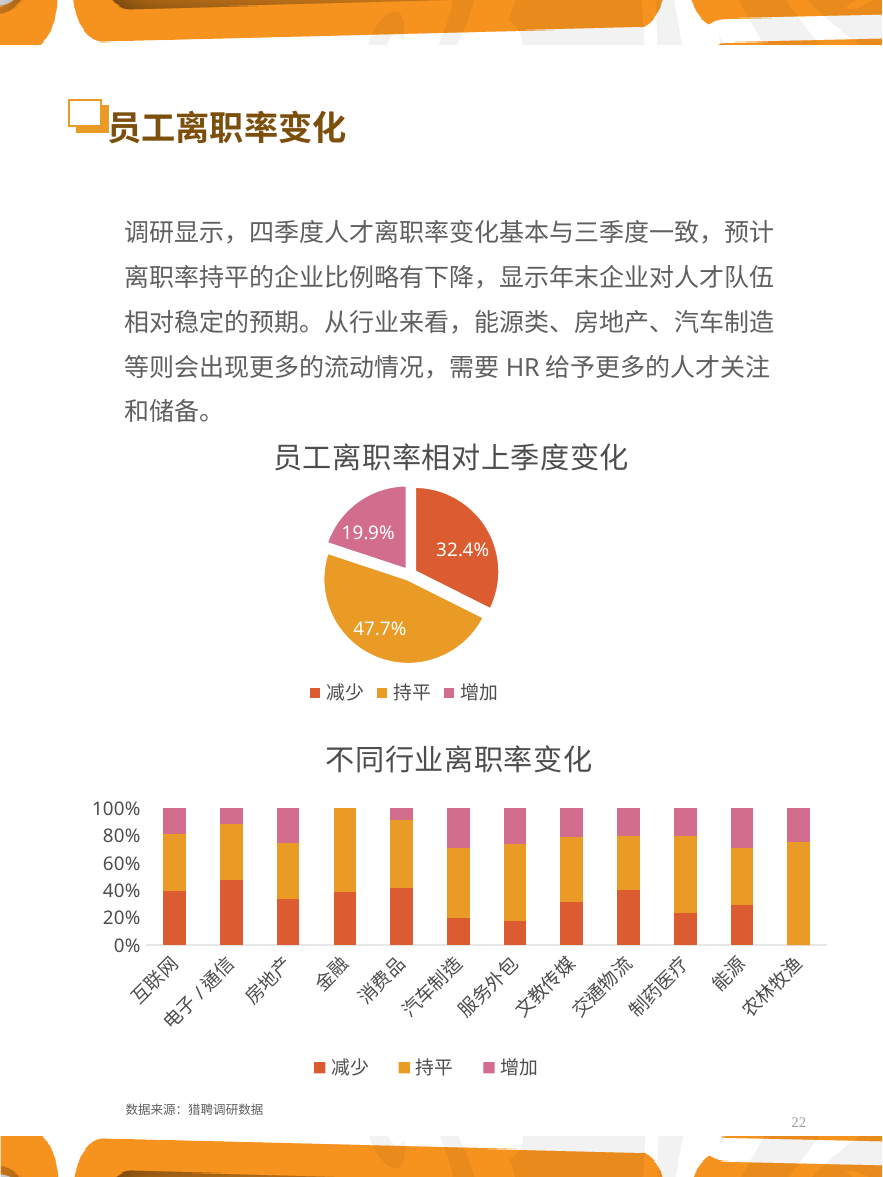
What kind of chart is 不同行业离职率变化? bar chart In the pie chart 员工离职率相对上季度变化, which category has the smallest share? 增加 How many series does the legend of the chart 不同行业离职率变化 list? 3 How many industries are shown on the x axis of the chart 不同行业离职率变化? 12 In the chart 不同行业离职率变化, is the 减少 value for 农林牧渔 greater or less than 20%? less In the pie chart 员工离职率相对上季度变化, what is the difference between 持平 and 减少? 15.3% In the pie chart 员工离职率相对上季度变化, what is the value for 减少? 32.4% In the pie chart 员工离职率相对上季度变化, what is the value for 持平? 47.7% In the pie chart 员工离职率相对上季度变化, which is larger, 减少 or 增加? 减少 What kind of chart is 员工离职率相对上季度变化? pie chart In the pie chart 员工离职率相对上季度变化, which category has the largest share? 持平 In the chart 不同行业离职率变化, is the 减少 value for 电子/通信 greater or less than 40%? greater